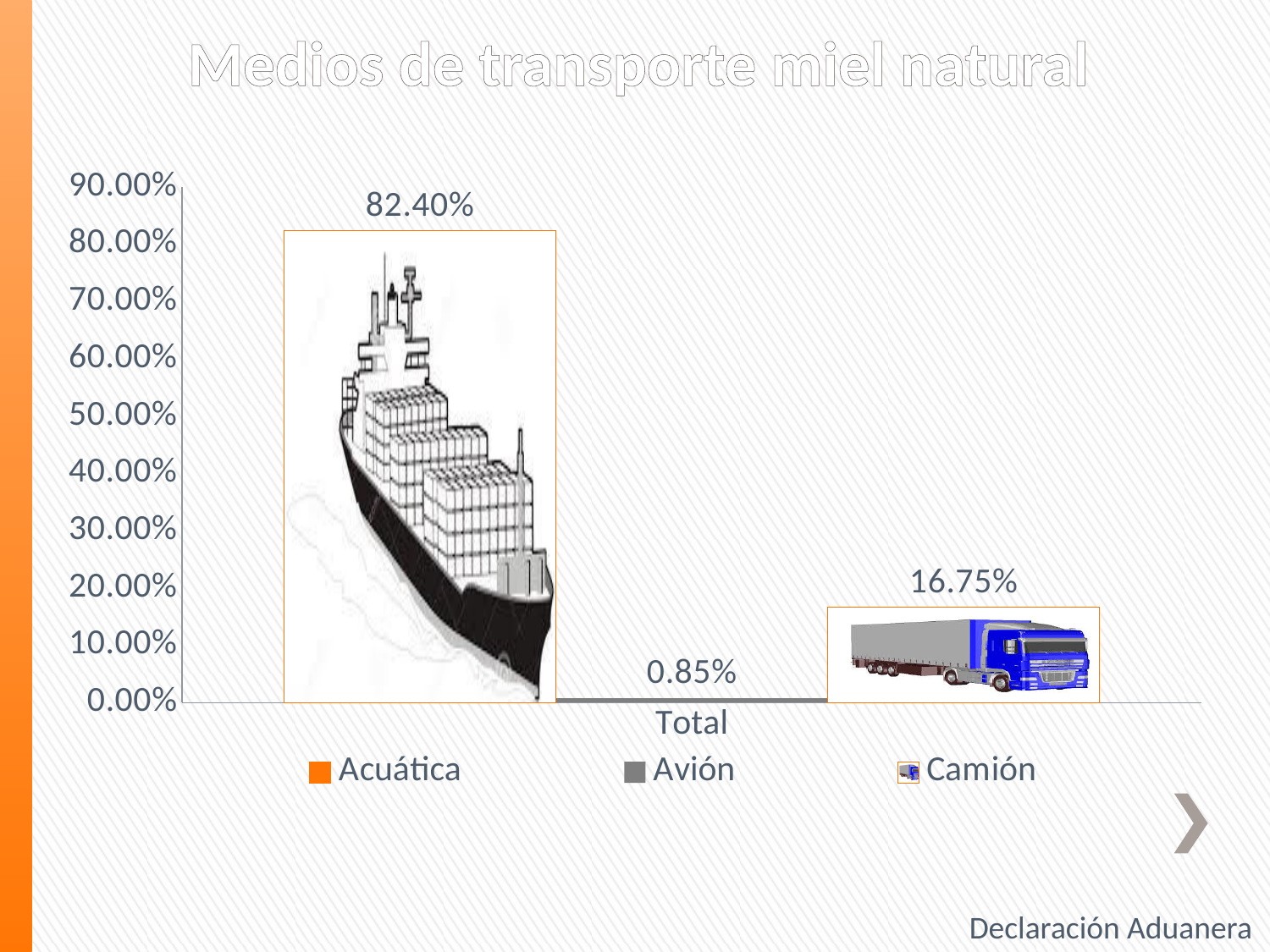
What is the difference between the values for Acuática and Camión? 65.65% How many series does the legend list? 3 Which is larger, the value for Camión or the value for Avión? Camión Is the value for Acuática greater or less than 80.00%? greater Which series has the lowest value? Avión What is the value for Camión? 16.75% What is the value for Acuática? 82.40% Which series has the highest value? Acuática What is the difference between the values for Camión and Avión? 15.90% What kind of chart is shown on the slide? bar chart What is the title of the chart? Medios de transporte miel natural What is the value for Avión? 0.85%